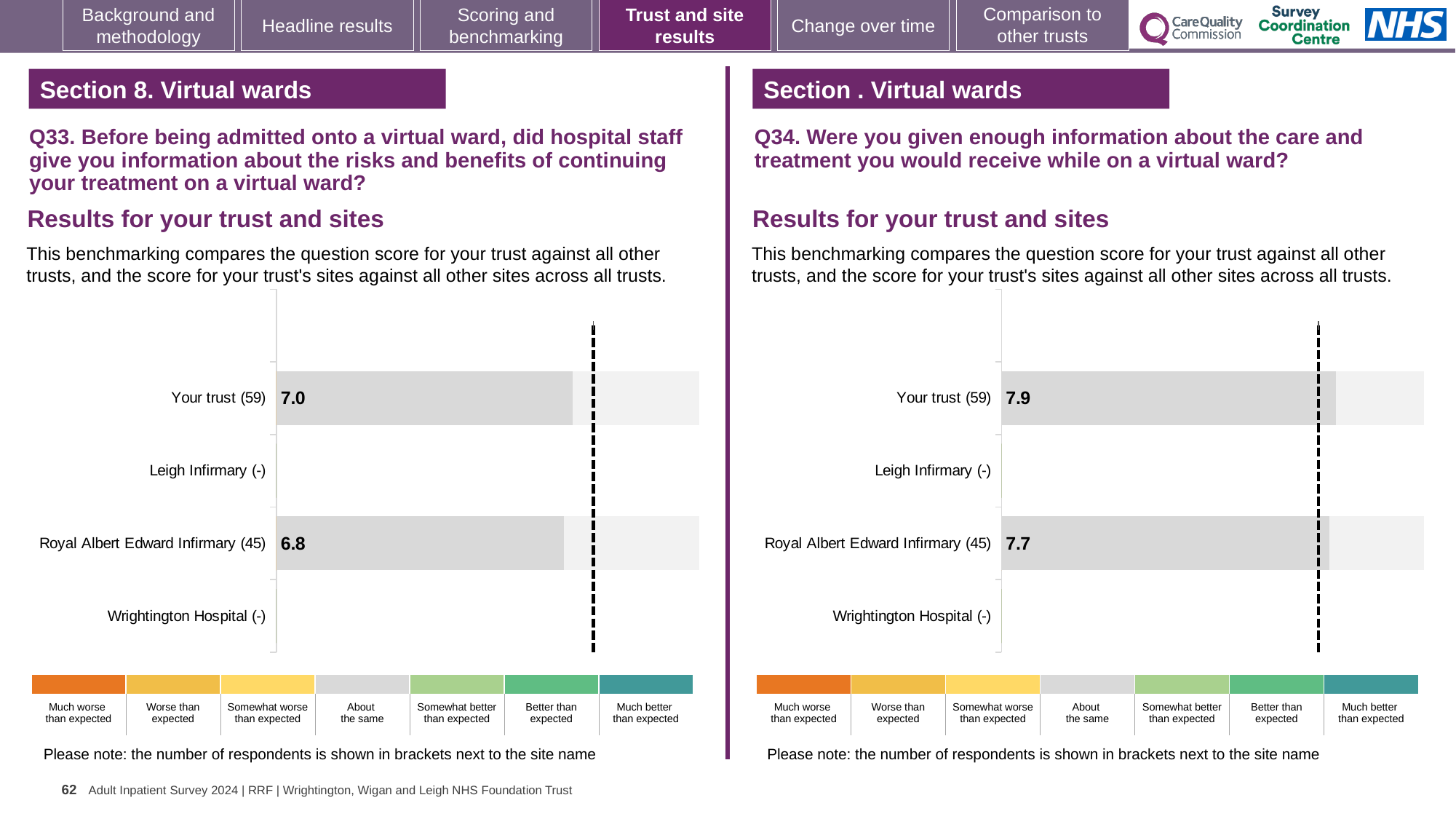
In the Q34 chart on the right, what is the score for Royal Albert Edward Infirmary? 7.7 In the Q33 chart on the left, which has the higher score: Your trust or Royal Albert Edward Infirmary? Your trust In the Q34 chart on the right, what is the difference between the score for Your trust and the score for Royal Albert Edward Infirmary? 0.2 In the Q33 chart on the left, what is the score for Royal Albert Edward Infirmary? 6.8 In the Q34 chart on the right, what is the score for Your trust? 7.9 In the Q33 chart on the left, what is the score for Your trust? 7.0 In the Q33 chart on the left, what is the difference between the score for Your trust and the score for Royal Albert Edward Infirmary? 0.2 How many categories (rows) are listed on the y axis of the Q33 chart on the left? 4 What kind of chart is the Q34 chart on the right? Bar chart In the Q33 chart on the left, which two sites have no score shown (marked with a dash)? Leigh Infirmary and Wrightington Hospital How many respondents are shown in brackets for Royal Albert Edward Infirmary in the Q34 chart on the right? 45 In the Q34 chart on the right, which has the higher score: Your trust or Royal Albert Edward Infirmary? Your trust